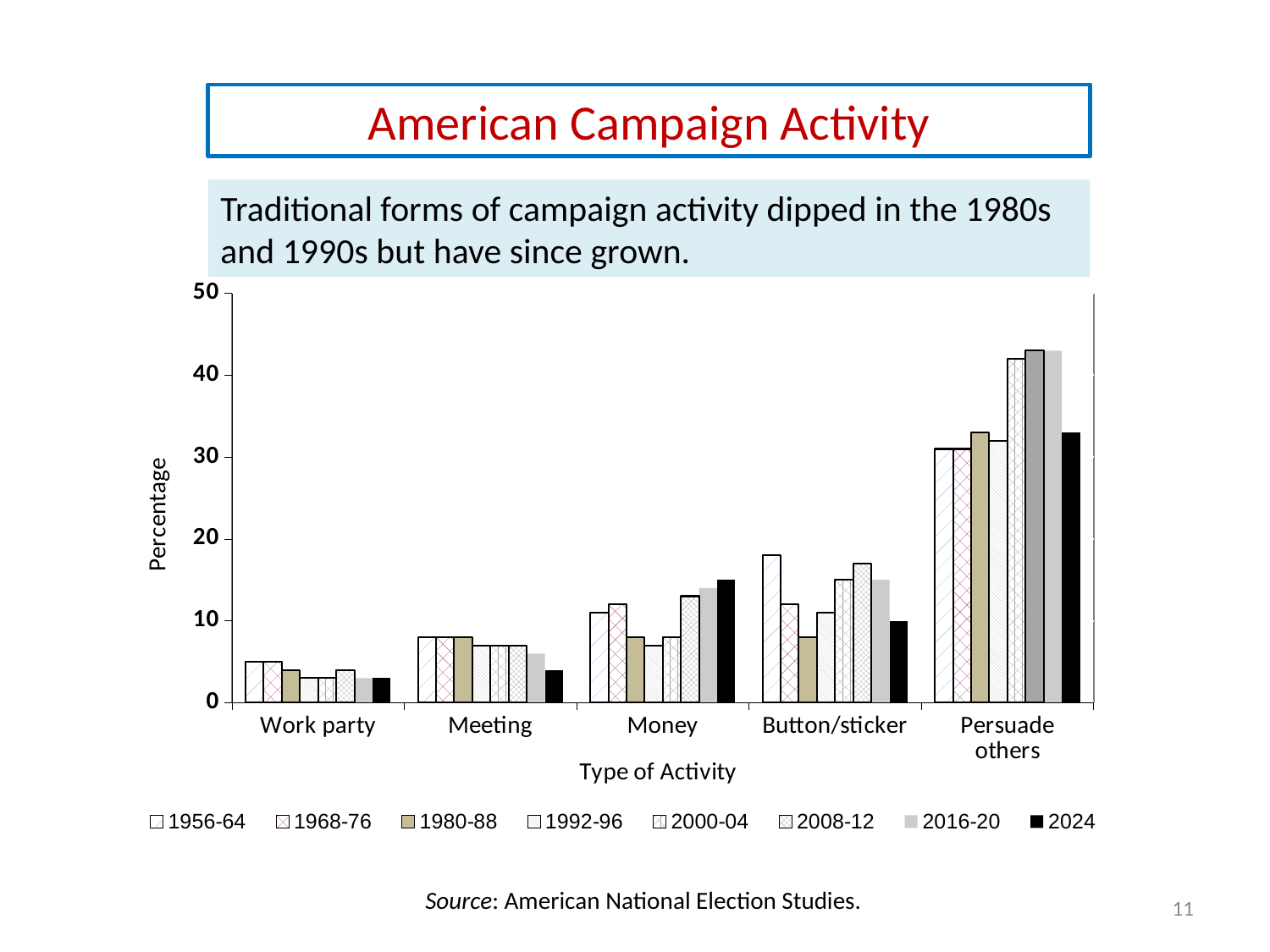
How many types of activity are shown on the x axis? 5 Is the value for Money in 2024 greater or less than 10? greater Which type of activity has the highest bars overall? Persuade others How many series does the legend list? 8 Is the value for Persuade others in 2024 greater or less than 40? less For Money, do the values generally rise or fall from 1980-88 to 2024? rise Is the value for Persuade others in 2016-20 greater or less than 40? greater What kind of chart is shown on the slide? bar chart What is the label on the y axis? Percentage Which type of activity has the lowest bars overall? Work party For Button/sticker, which is larger: the value for 1956-64 or the value for 2024? 1956-64